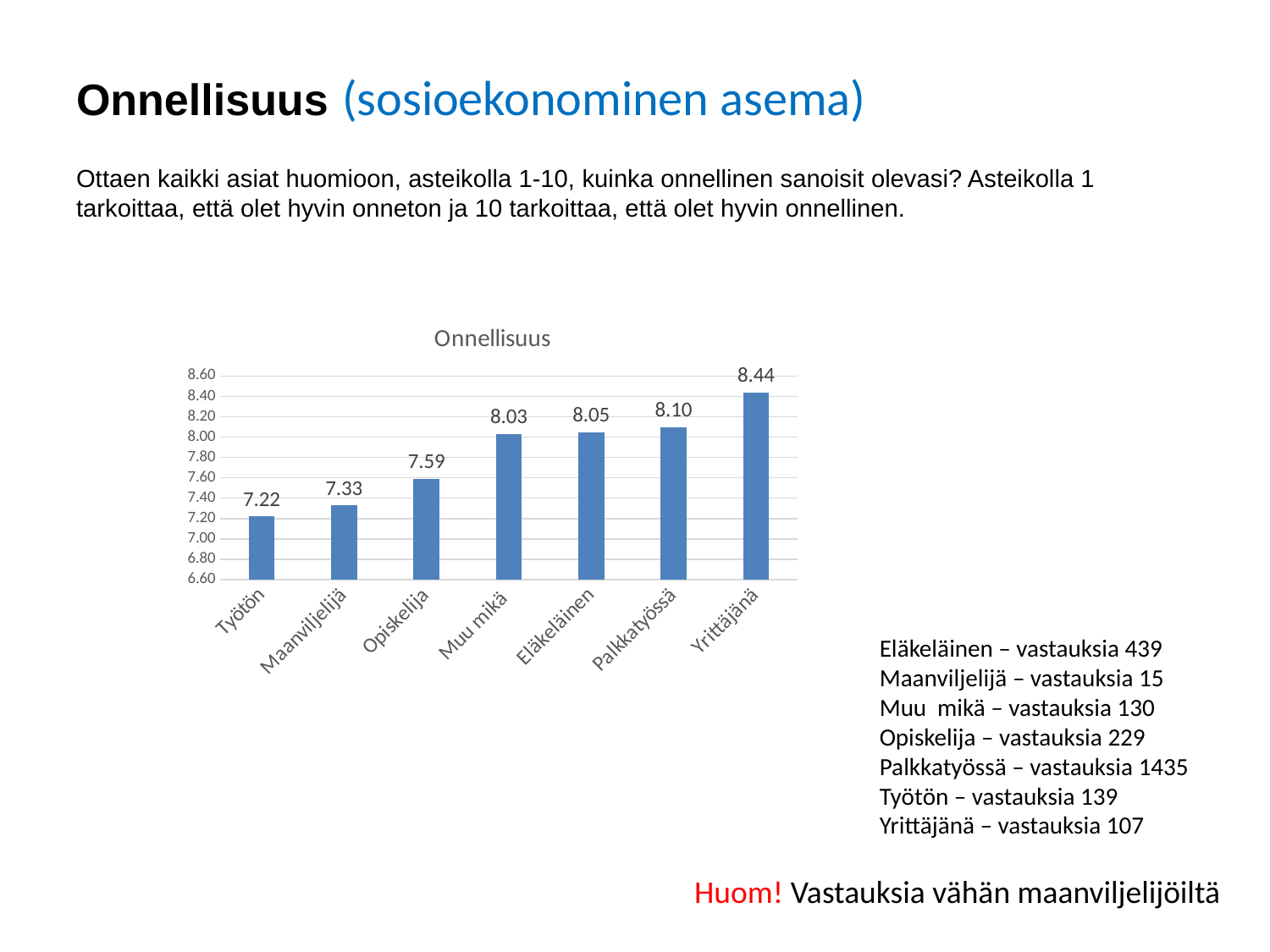
What is the value for Työtön? 7.22 What is the title of the chart? Onnellisuus What is the difference between the values for Yrittäjänä and Työtön? 1.22 Which category has the highest value? Yrittäjänä Which category has the lowest value? Työtön What is the value for Opiskelija? 7.59 Do the values rise or fall from left to right along the x axis? rise How many categories are shown on the x axis? 7 What kind of chart is this? bar chart Which is larger, the value for Maanviljelijä or the value for Eläkeläinen? Eläkeläinen What is the difference between the values for Muu mikä and Opiskelija? 0.44 What is the value for Palkkatyössä? 8.10